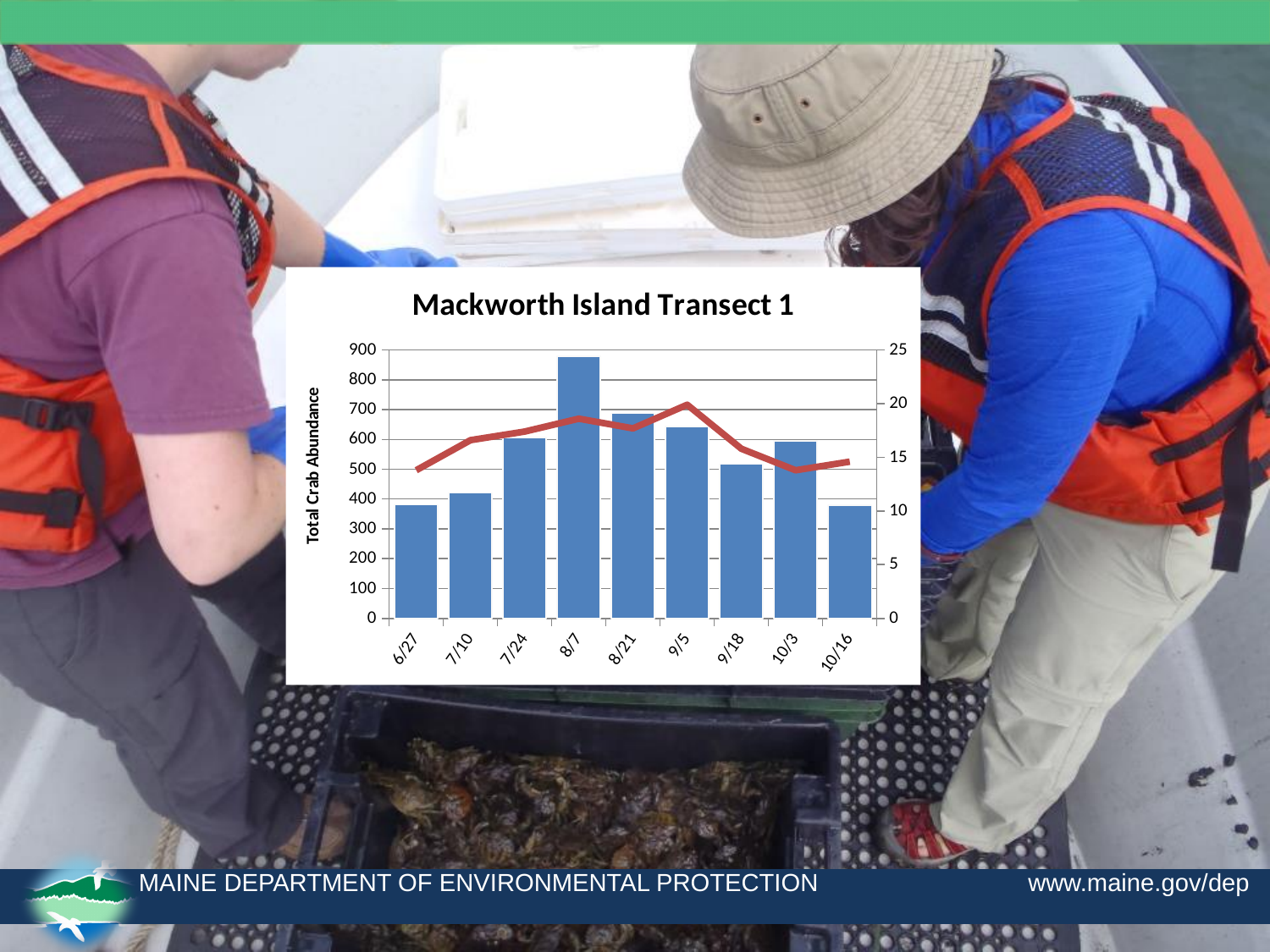
Which date has the larger Total Crab Abundance bar, 8/21 or 9/18? 8/21 Do the Total Crab Abundance bars rise or fall from 6/27 to 8/7? rise How many dates are shown along the x axis of the chart? 9 Is the Total Crab Abundance bar for 8/7 greater or less than 800? greater Is the Total Crab Abundance bar for 7/24 greater or less than 500? greater Is the Total Crab Abundance bar for 6/27 greater or less than 400? less What is the label on the left vertical axis of the chart? Total Crab Abundance What is the title of the chart? Mackworth Island Transect 1 Which date has the highest bar for Total Crab Abundance? 8/7 Which date has the larger Total Crab Abundance bar, 7/10 or 7/24? 7/24